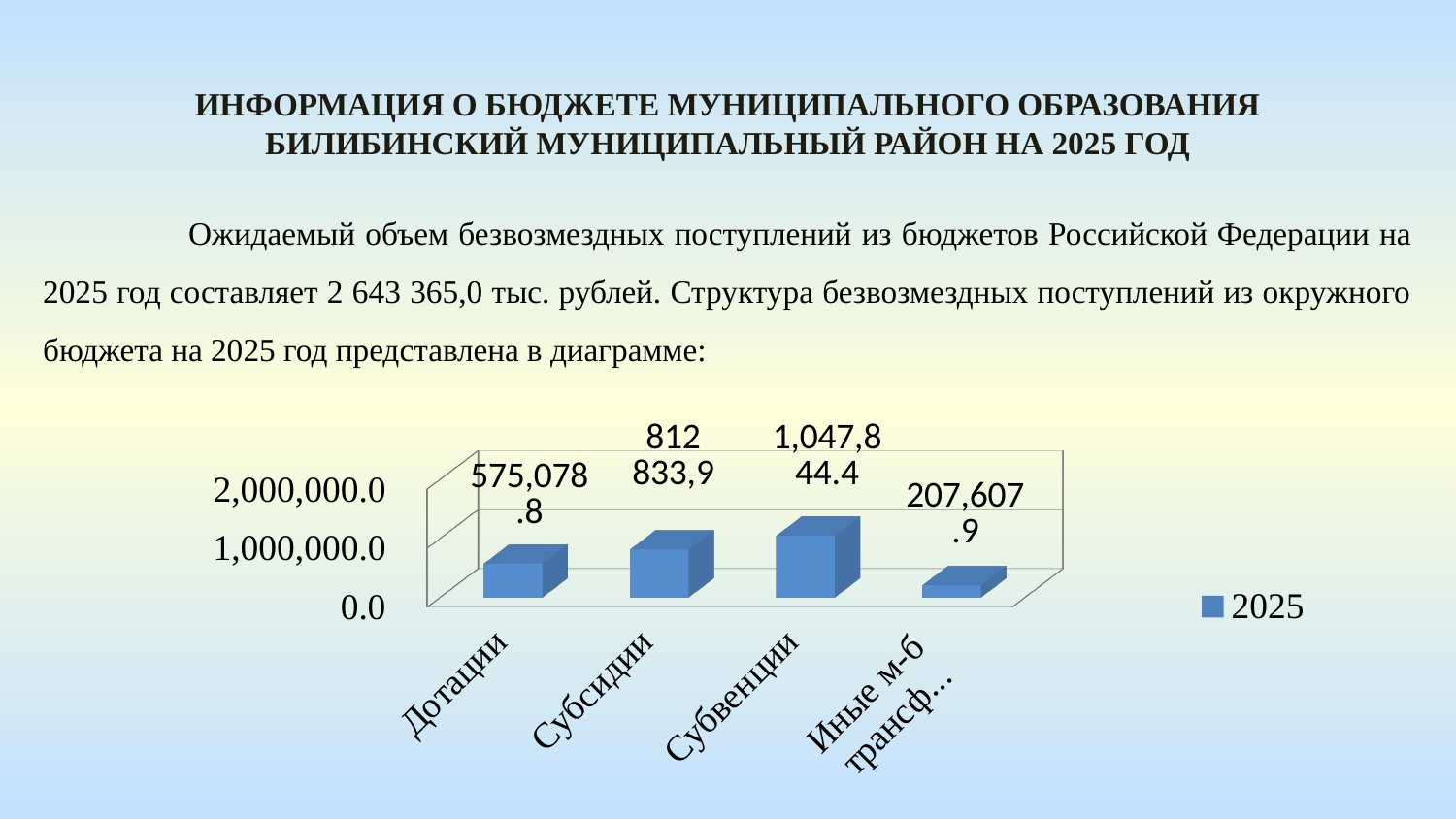
How many categories are shown on the x axis of the chart? 4 Is the value for Дотации greater or less than 1,000,000.0? less Which category has the highest value? Субвенции What is the value for Субвенции? 1,047,844.4 How many series does the chart legend list? 1 What is the difference between the values for Субвенции and Дотации? 472,765.6 What type of chart is shown on the slide? bar chart What is the value for Дотации? 575,078.8 Which is larger, the value for Субсидии or the value for Дотации? Субсидии What is the value for Иные м-б трансф...? 207,607.9 What series name is shown in the chart legend? 2025 Which category has the lowest value? Иные м-б трансф...